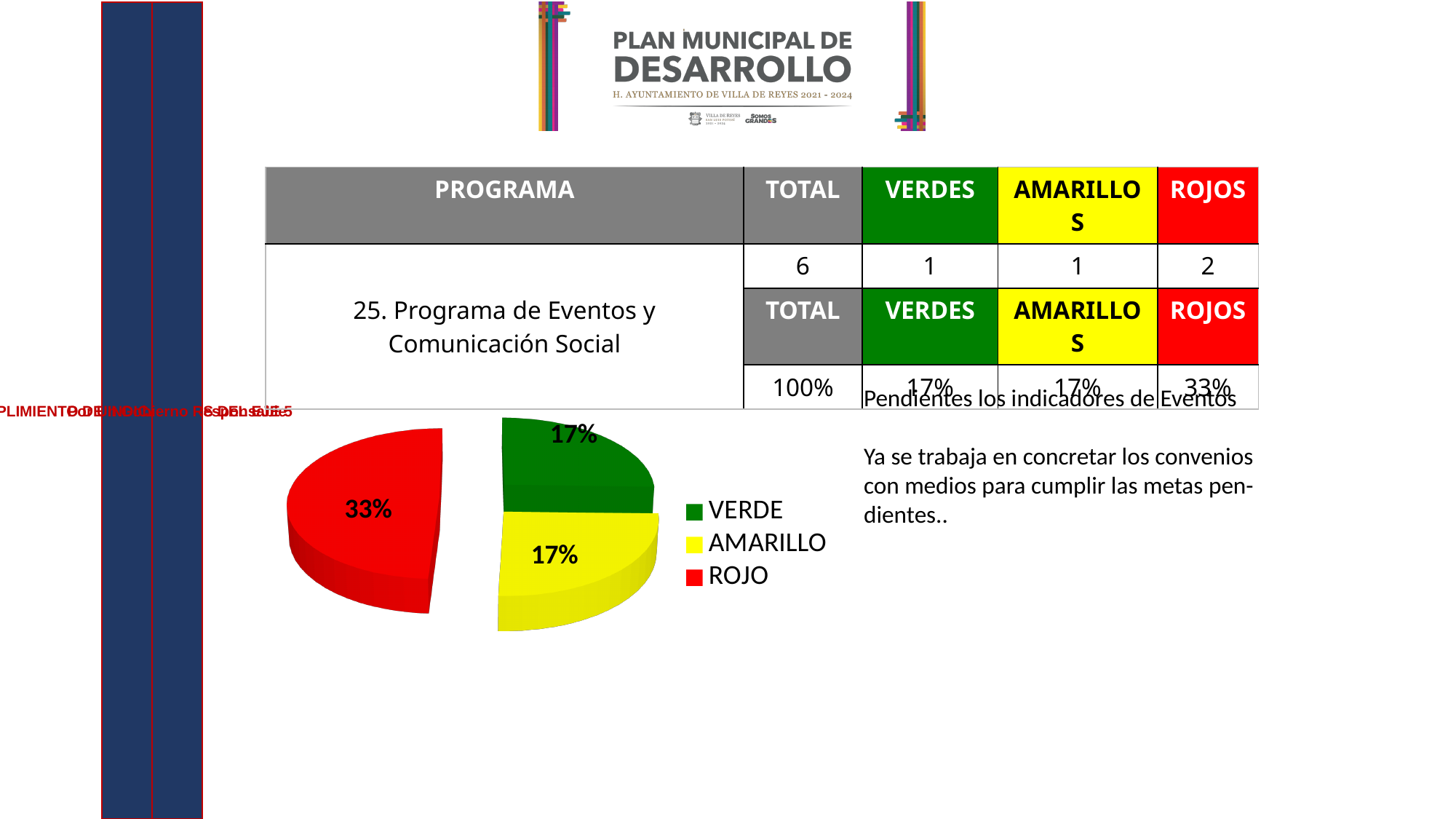
What percentage is shown for the AMARILLO slice of the pie chart? 17% Which slice of the pie chart is the largest? ROJO What percentage is shown for the VERDE slice of the pie chart? 17% What percentage is shown for the ROJO slice of the pie chart? 33% What is the difference in percentage points between the ROJO slice and the AMARILLO slice? 16 How many entries does the pie chart's legend list? 3 How many slices does the pie chart have? 3 Which is larger in the pie chart, the ROJO slice or the VERDE slice? ROJO Which legend entry is shown in yellow? AMARILLO What colour is the ROJO slice in the pie chart? red What kind of chart is shown on the slide? pie chart